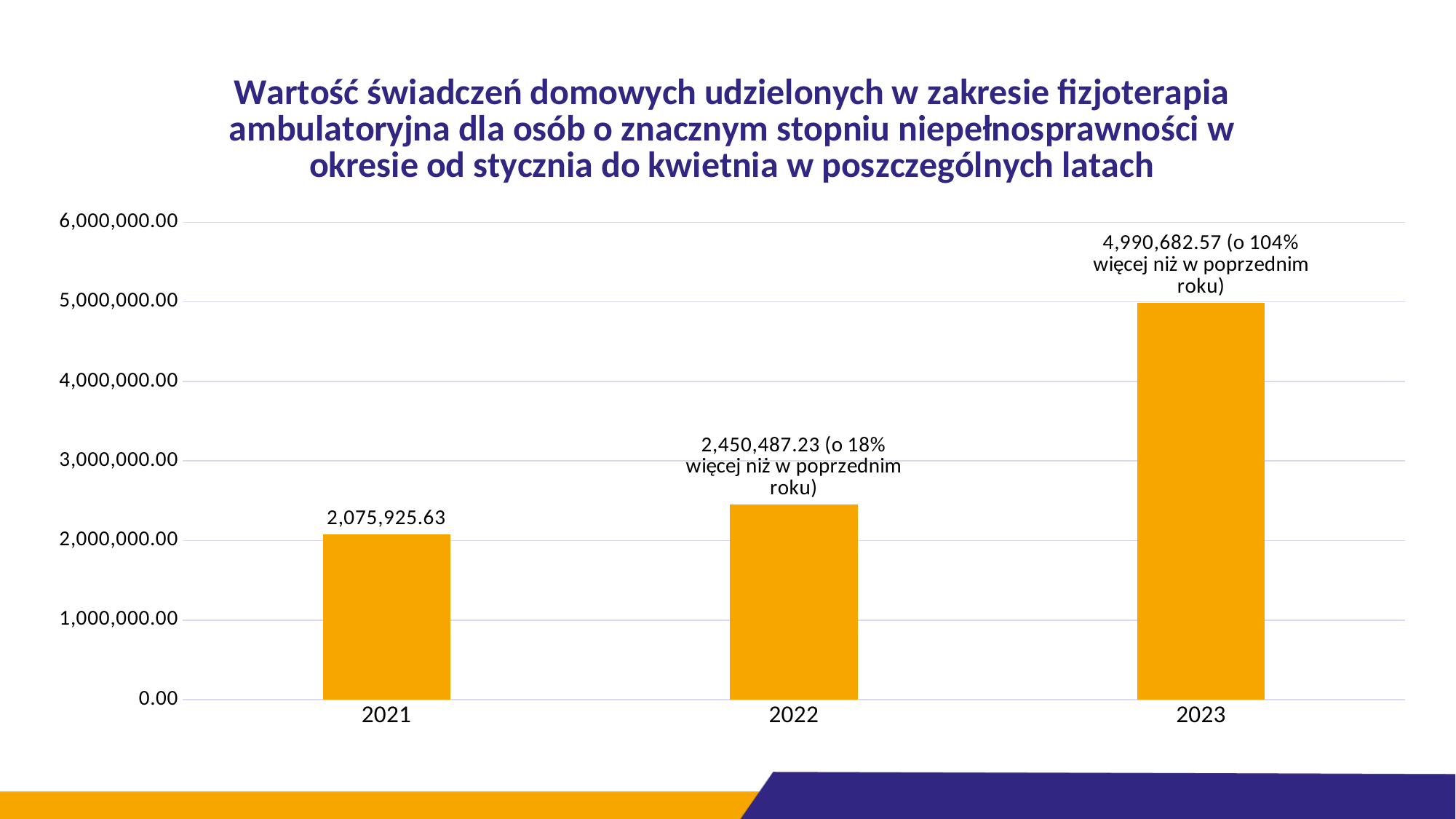
What kind of chart is this? bar chart What is the value for 2022? 2,450,487.23 What is the value for 2023? 4,990,682.57 Which year has the highest value? 2023 How many years are shown on the x axis? 3 Is the value for 2023 greater or less than 4,000,000.00? greater What is the difference between the values for 2022 and 2021? 374,561.60 Which year has the lowest value? 2021 What is the value for 2021? 2,075,925.63 Which is larger, the value for 2022 or the value for 2021? 2022 What is the difference between the values for 2023 and 2022? 2,540,195.34 Do the values rise or fall from 2021 to 2023? rise